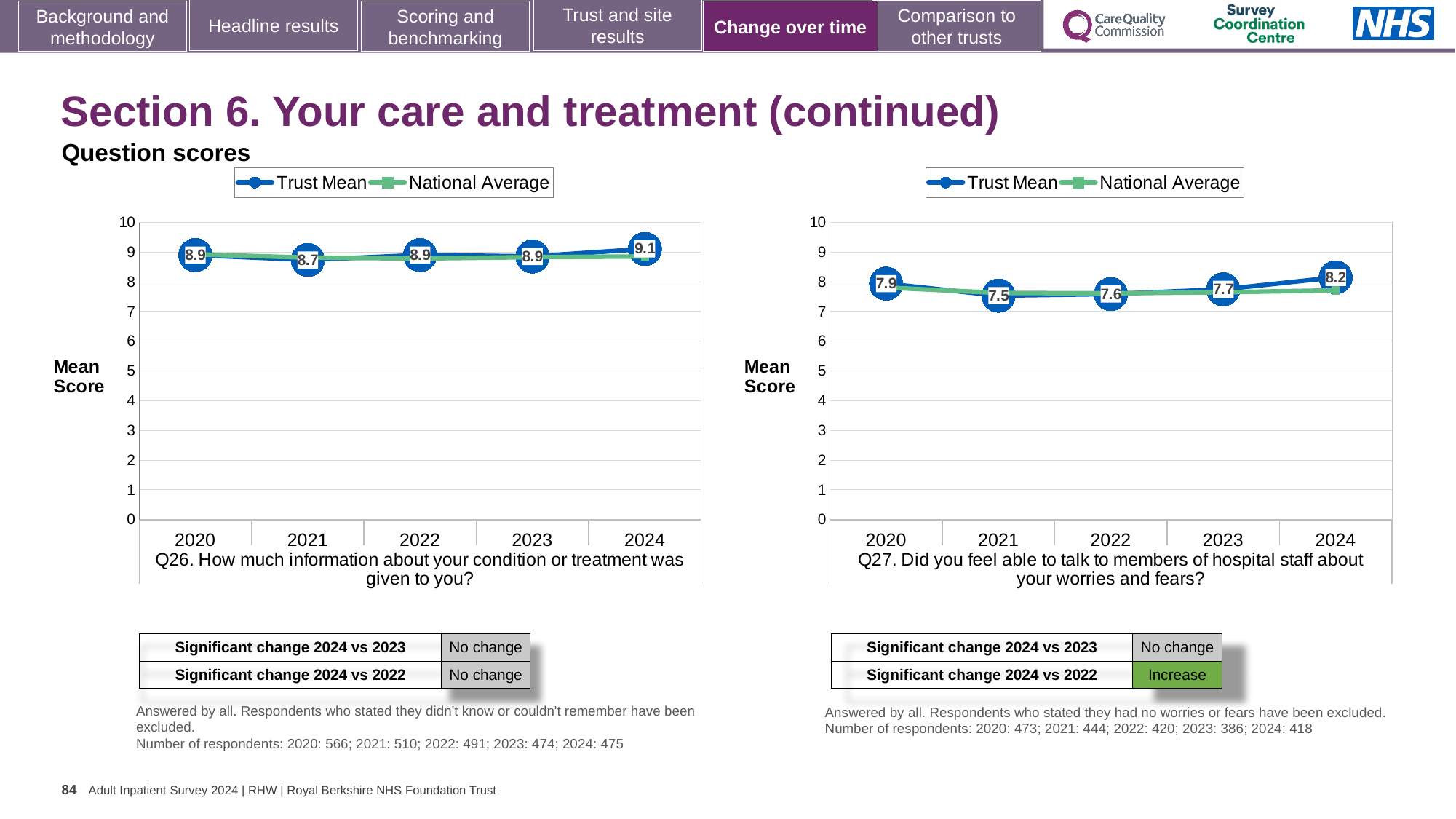
In the Q26 chart (left), what is the Trust Mean score for 2024? 9.1 In the Q27 chart (right), which year has the highest Trust Mean score? 2024 In the Q27 chart (right), is the Trust Mean value for 2021 greater or less than 8? less In the Q27 chart (right), what is the difference between the Trust Mean scores for 2024 and 2022? 0.6 In the Q27 chart (right), which year has the lowest Trust Mean score? 2021 How many series does the legend of the Q27 chart (right) list? 2 How many years are plotted on the x axis of the Q26 chart (left)? 5 In the Q27 chart (right), what is the Trust Mean score for 2020? 7.9 In the Q26 chart (left), which is larger, the Trust Mean score for 2021 or for 2024? 2024 What kind of chart is the Q26 chart (left)? Line chart In the Q27 chart (right), does the Trust Mean score rise or fall from 2021 to 2024? Rise In the Q26 chart (left), what is the Trust Mean score for 2021? 8.7